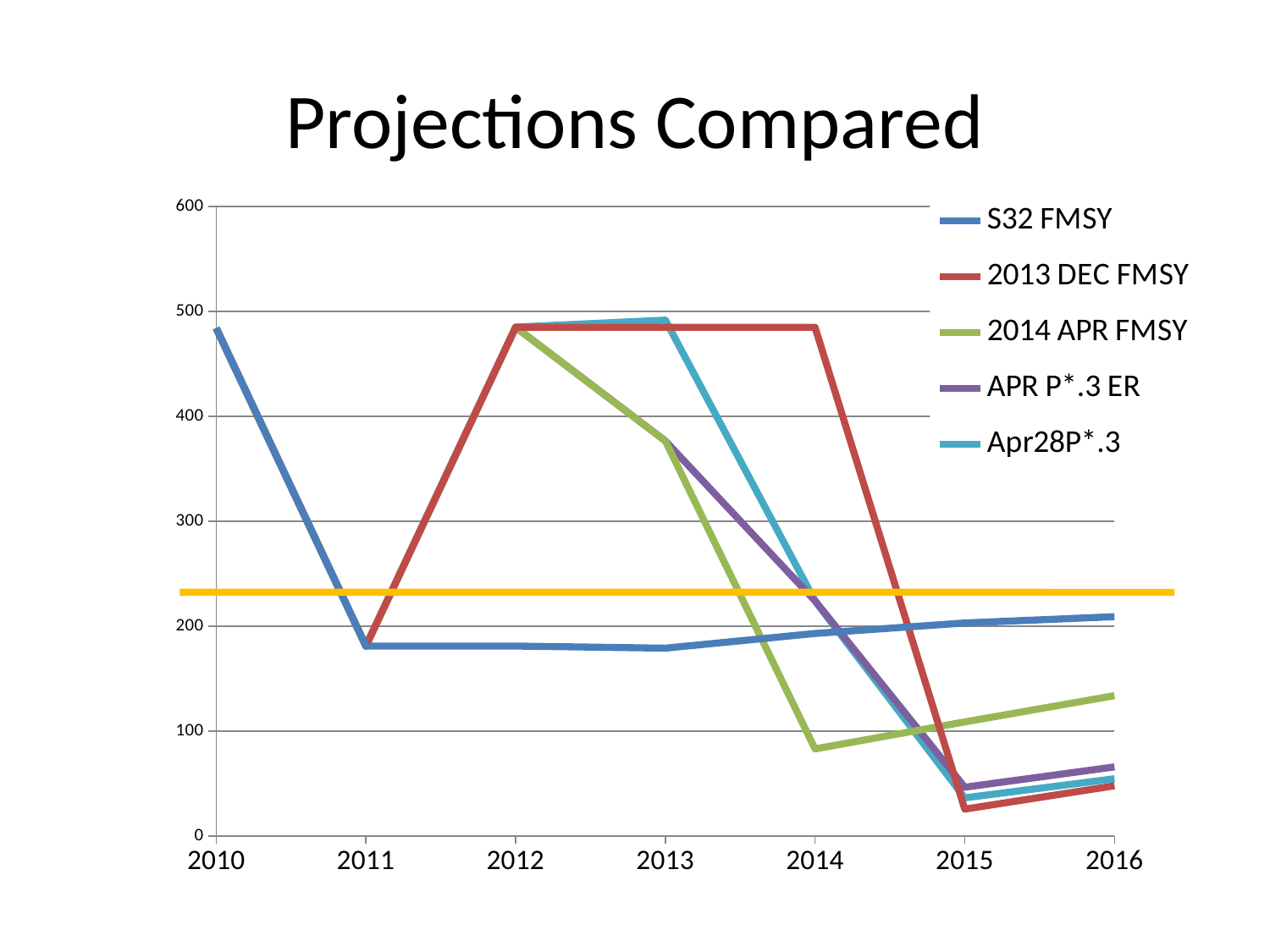
Does the 2013 DEC FMSY series rise or fall from 2014 to 2015? fall Is the value for S32 FMSY in 2010 greater or less than 400? greater Is the value for 2014 APR FMSY in 2014 greater or less than 100? less What kind of chart is shown on the slide? line chart Is the value for Apr28P*.3 in 2013 greater or less than 400? greater How many series does the legend list? 5 Which colour is used for the 2013 DEC FMSY series? red Which series has the highest value in 2015? S32 FMSY How many years are shown along the x axis? 7 What is the title of the chart? Projections Compared In 2016, which is larger: 2014 APR FMSY or 2013 DEC FMSY? 2014 APR FMSY